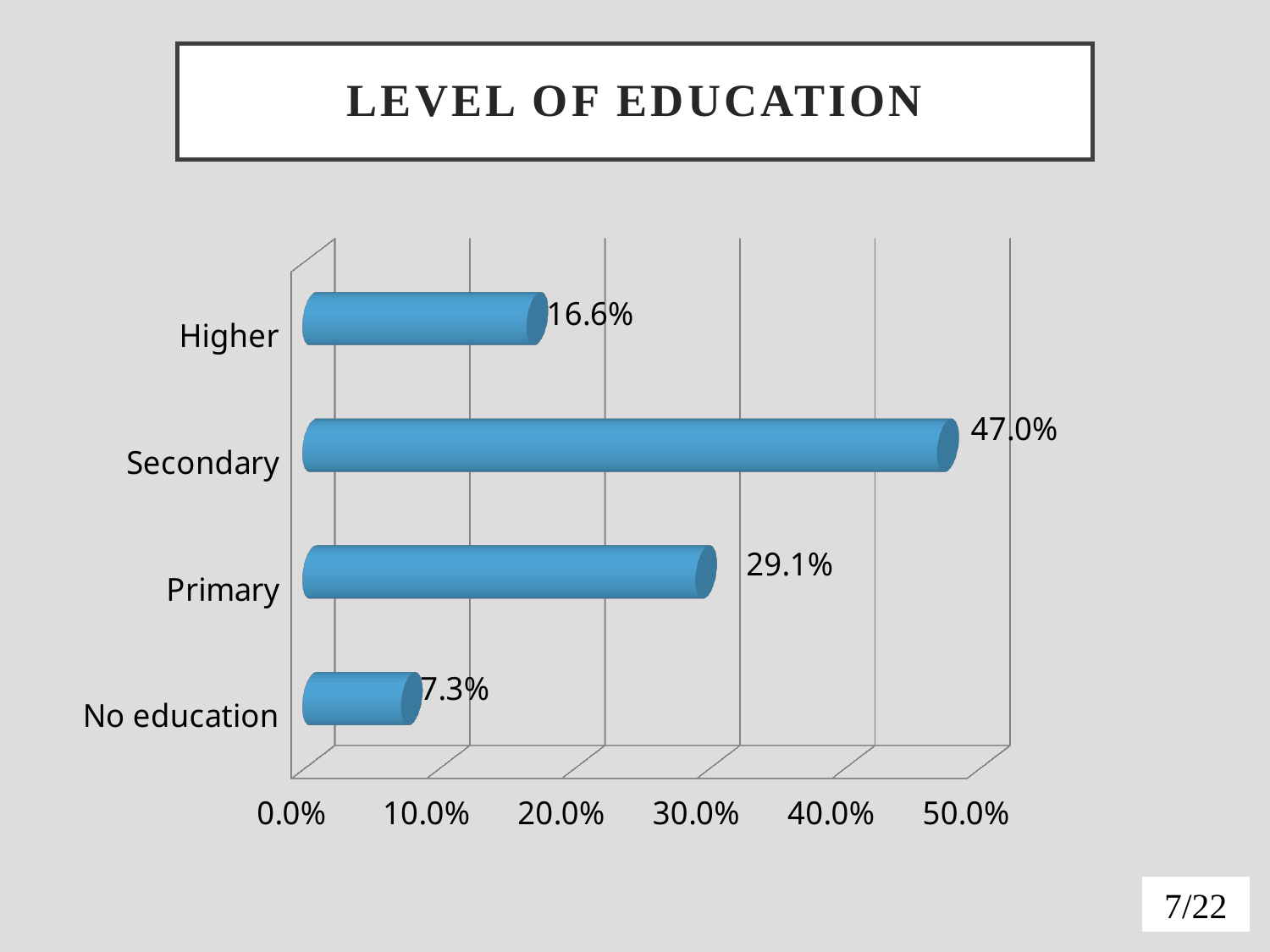
Which level of education has the lowest value? No education What is the value for Primary? 29.1% What is the difference between the values for Secondary and Primary? 17.9% What kind of chart is shown on the slide? Bar chart How many categories are shown in the chart? 4 Which is larger, the value for Primary or the value for Higher? Primary What is the value for Higher? 16.6% What is the value for Secondary? 47.0% What is the difference between the values for Higher and No education? 9.3% What is the title of the chart? LEVEL OF EDUCATION What is the value for No education? 7.3% Which level of education has the highest value? Secondary